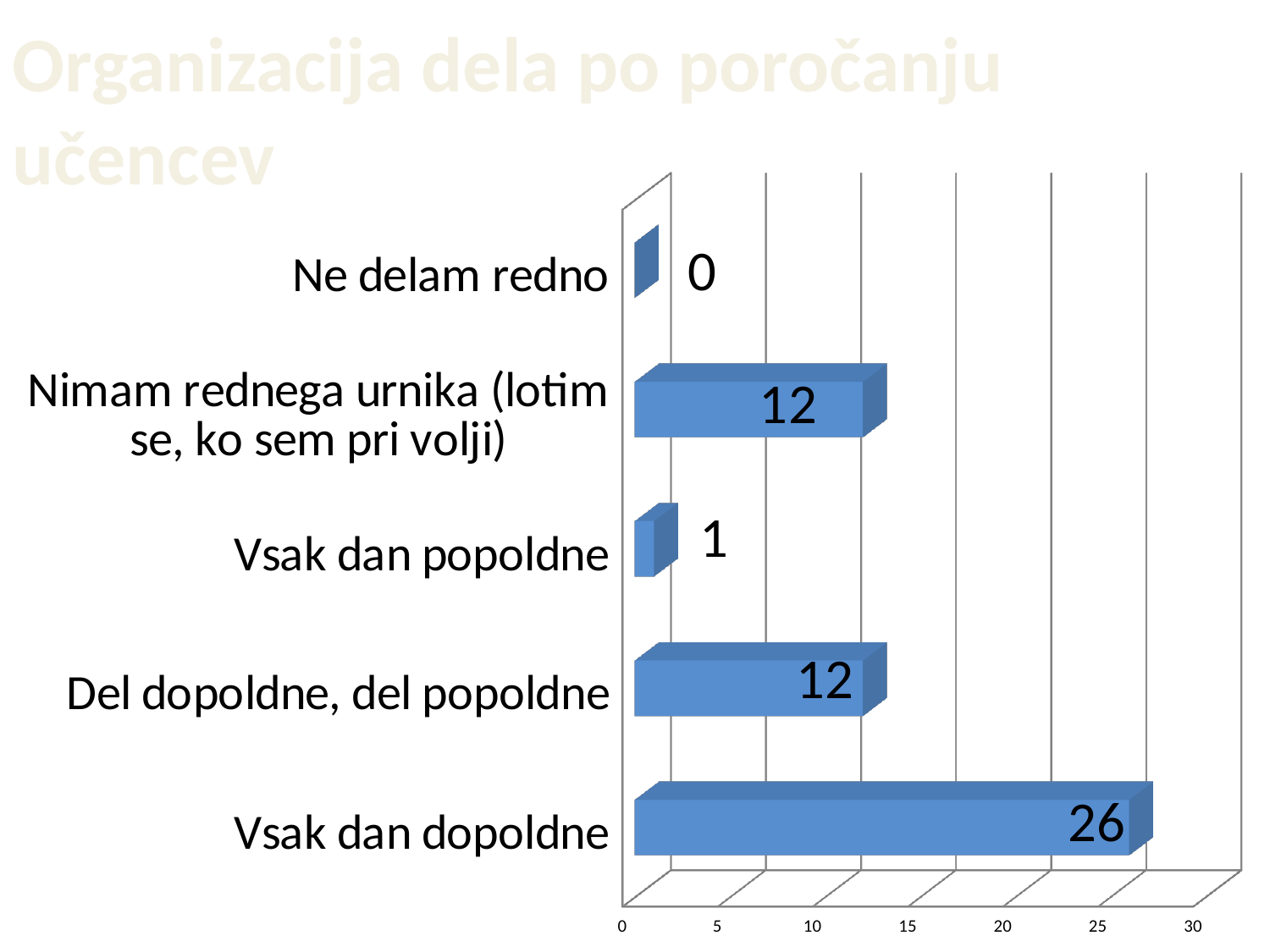
Which category has the highest value? Vsak dan dopoldne What is the value for "Ne delam redno"? 0 Which category has the lowest value? Ne delam redno What is the value for "Vsak dan dopoldne"? 26 Which is larger: the value for "Vsak dan popoldne" or the value for "Nimam rednega urnika (lotim se, ko sem pri volji)"? Nimam rednega urnika (lotim se, ko sem pri volji) Is the value for "Vsak dan dopoldne" greater or less than 25? greater What is the difference between the values for "Vsak dan dopoldne" and "Del dopoldne, del popoldne"? 14 What is the title of the slide? Organizacija dela po poročanju učencev What is the value for "Del dopoldne, del popoldne"? 12 What is the value for "Vsak dan popoldne"? 1 What kind of chart is shown on the slide? bar chart How many categories are shown in the chart? 5